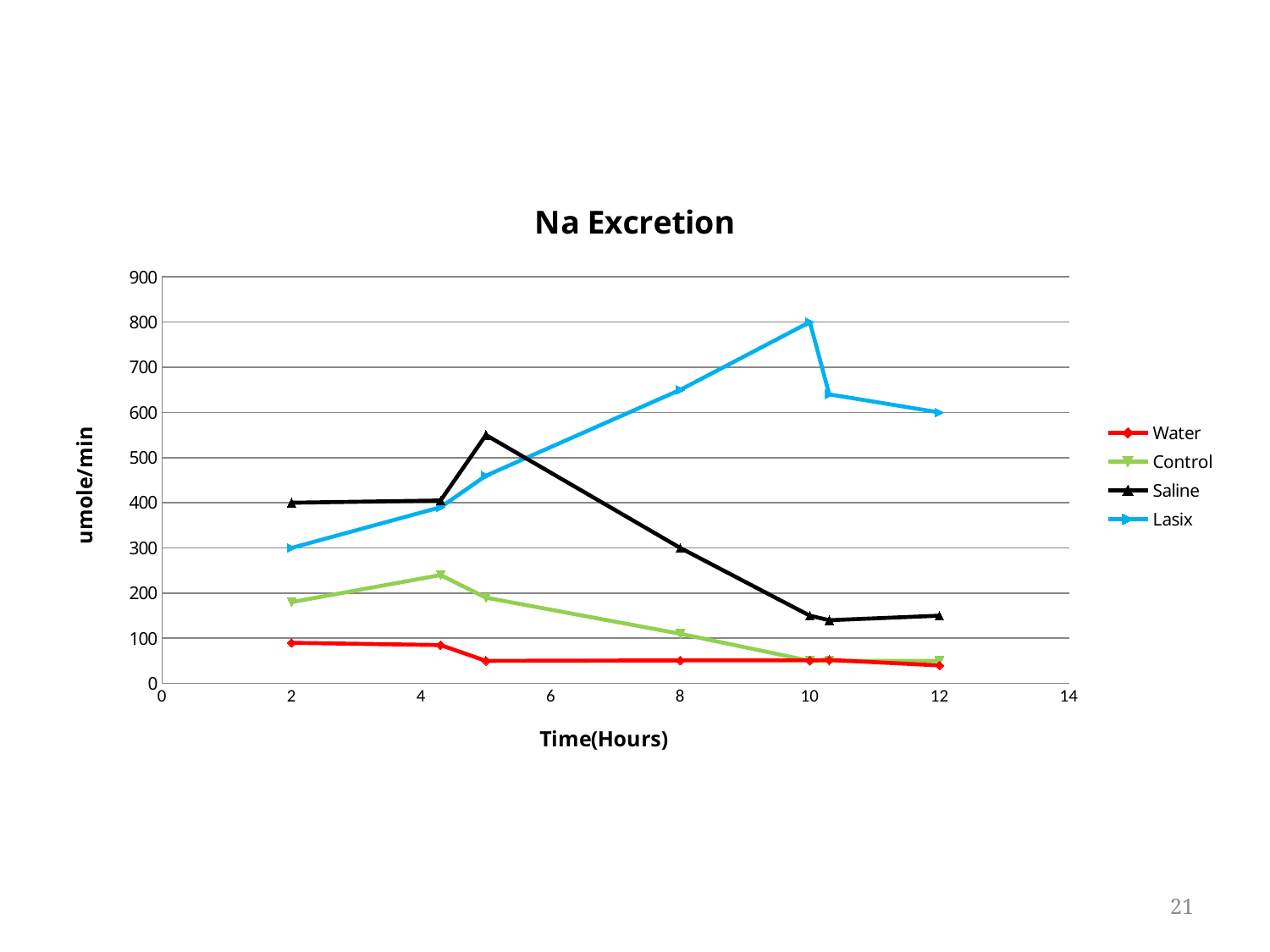
What is the Lasix value at 10 hours? 800 Which series has the lowest values across the chart? Water What is the Lasix value at 2 hours? 300 What kind of chart is shown on the slide? line chart What is the Saline value at 2 hours? 400 At 8 hours, which is larger, Saline or Lasix? Lasix What is the label of the y axis? umole/min How many series does the legend list? 4 Is the Saline value at 5 hours greater or less than 500? greater What is the title of the chart? Na Excretion Which series reaches the highest value on the chart? Lasix Does the Lasix series rise or fall between 2 and 10 hours? rise